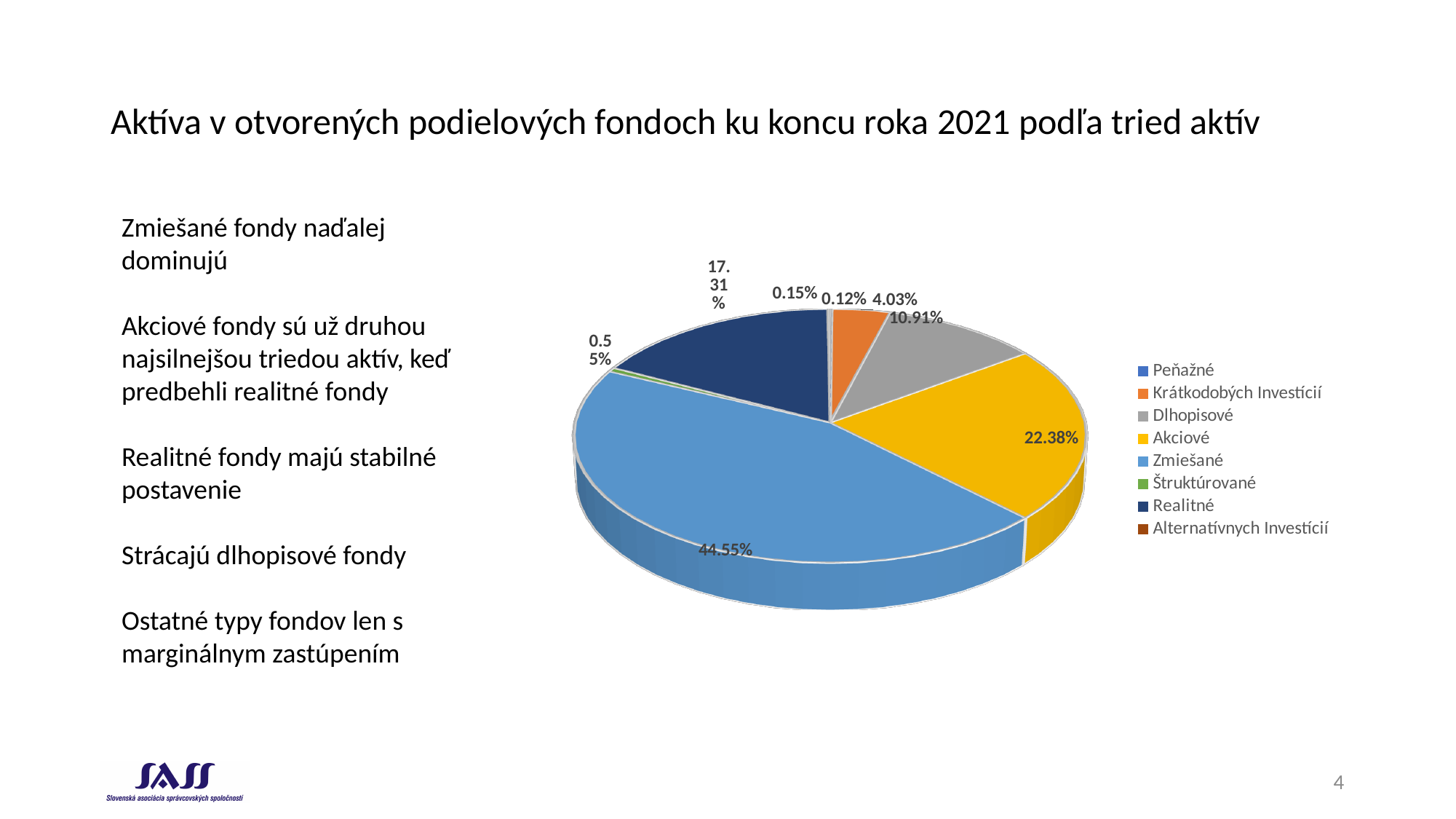
Which has a larger share, Akciové or Realitné? Akciové What kind of chart is shown on the slide? pie chart What is the title of the slide containing the chart? Aktíva v otvorených podielových fondoch ku koncu roka 2021 podľa tried aktív How many categories does the legend list? 8 What percentage is shown for Realitné funds? 17.31% Which category has the largest slice of the pie? Zmiešané What percentage is shown for Akciové funds? 22.38% What percentage is shown for Dlhopisové funds? 10.91% How many percentage points larger is the Zmiešané share than the Akciové share? 22.17 What percentage is shown for Krátkodobých Investícií funds? 4.03% What is the smallest percentage labelled on the pie chart? 0.12% What share of assets do Zmiešané funds hold in the pie chart? 44.55%